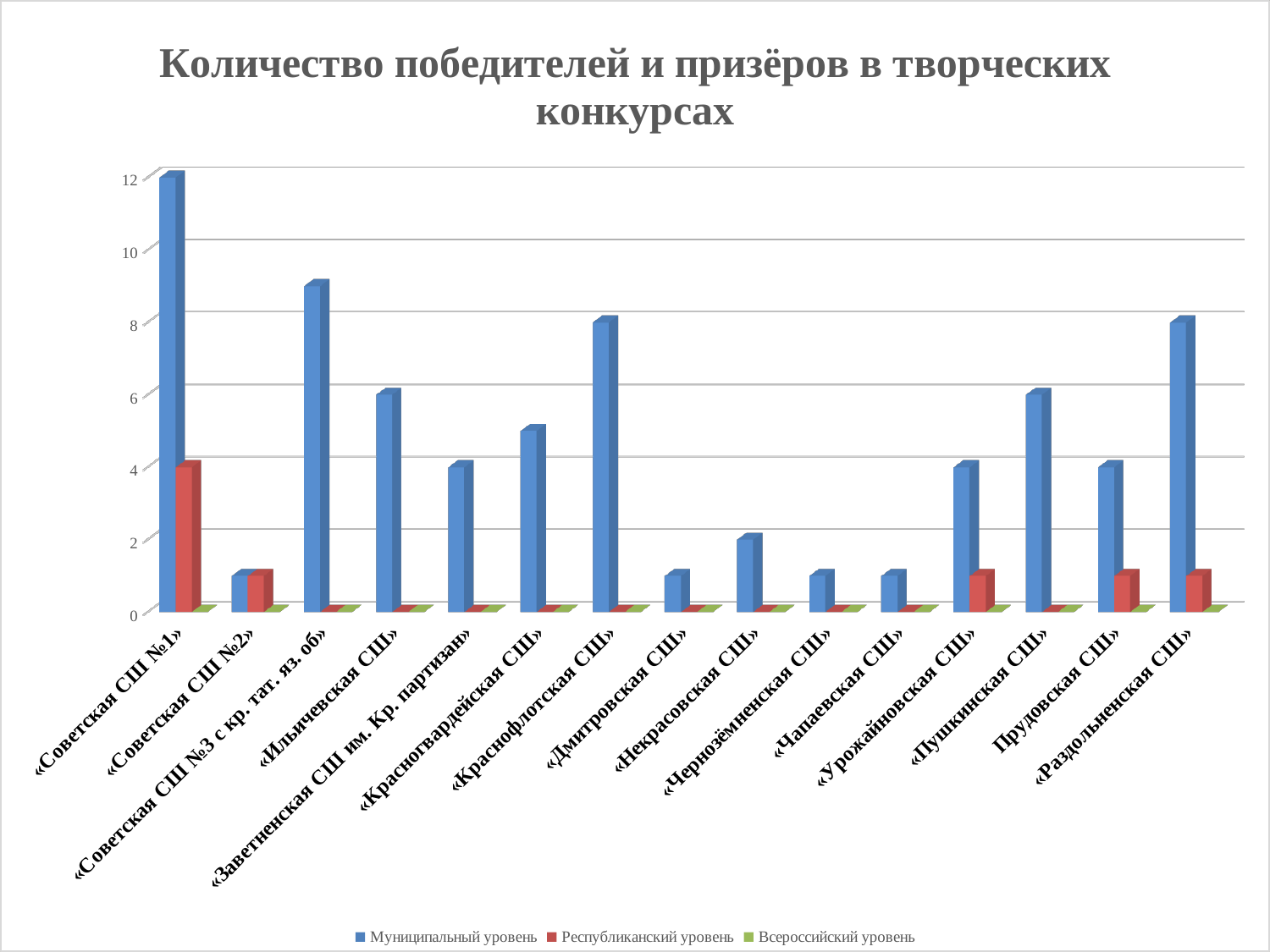
What is the title of the chart? Количество победителей и призёров в творческих конкурсах What kind of chart is shown on the slide? bar chart Which school has the highest value for Муниципальный уровень? «Советская СШ №1» What is the value for Муниципальный уровень at «Советская СШ №1»? 12 What is the value for Муниципальный уровень at «Краснофлотская СШ»? 8 Is the value for Муниципальный уровень at «Советская СШ №3 с кр. тат. яз. об» greater or less than 8? greater How many series does the legend list? 3 Is the value for Муниципальный уровень at «Красногвардейская СШ» greater or less than 4? greater Which is larger for Муниципальный уровень: «Советская СШ №3 с кр. тат. яз. об» or «Ильичевская СШ»? «Советская СШ №3 с кр. тат. яз. об» How many schools (categories) are shown on the x axis? 15 What is the value for Республиканский уровень at «Советская СШ №1»? 4 What is the value for Муниципальный уровень at «Ильичевская СШ»? 6